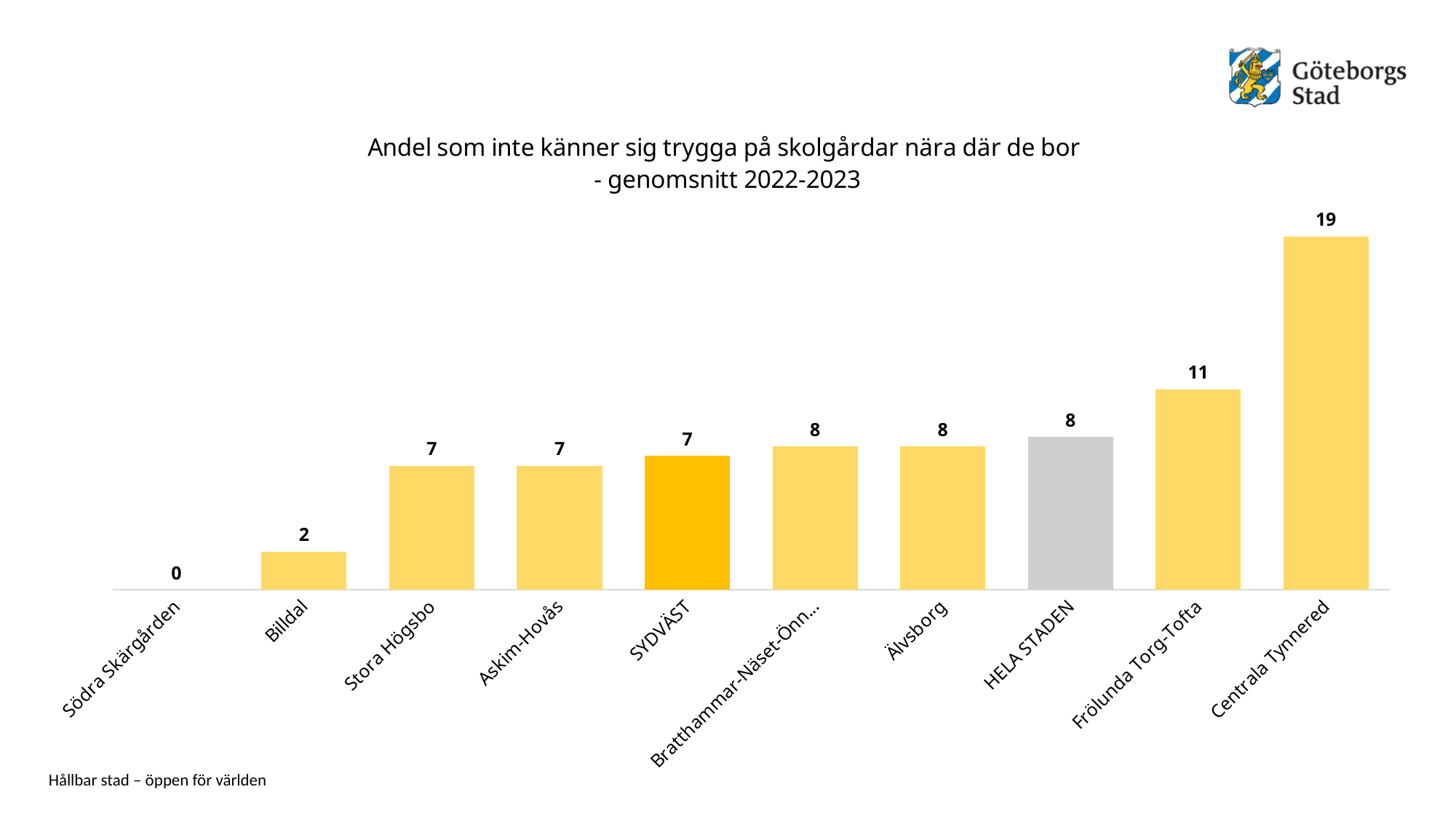
Which category has the highest value? Centrala Tynnered What is the value for HELA STADEN? 8 Which category has the lowest value? Södra Skärgården What kind of chart is this? Bar chart What is the difference between the values for Centrala Tynnered and Frölunda Torg-Tofta? 8 What is the value for Centrala Tynnered? 19 Which is larger, the value for Frölunda Torg-Tofta or the value for Älvsborg? Frölunda Torg-Tofta Which bar is coloured grey rather than yellow? HELA STADEN What is the difference between the values for HELA STADEN and Billdal? 6 What is the value for Billdal? 2 What is the value for SYDVÄST? 7 How many categories are shown on the x axis? 10